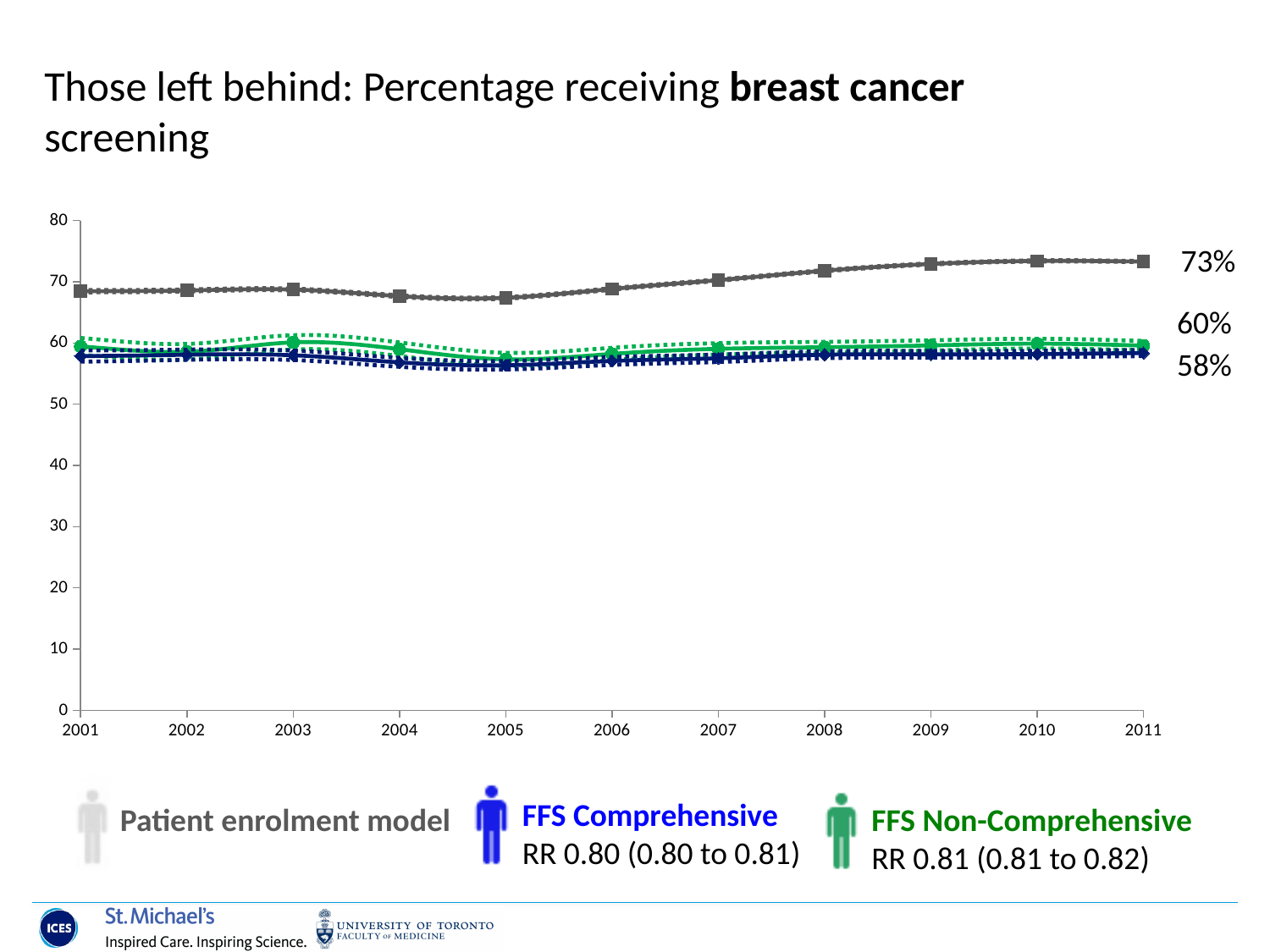
What kind of chart is shown on the slide? line chart How many series (groups) are plotted in the chart? 3 What is the difference between the 2011 percentages for the Patient enrolment model and FFS Comprehensive? 15 percentage points What percentage is labelled for the FFS Non-Comprehensive line at the end of the chart (2011)? 60% How many years are shown along the x axis of the chart? 11 Is the value for the Patient enrolment model in 2001 greater or less than 70? less Which group has the lowest percentage receiving breast cancer screening in 2011? FFS Comprehensive What percentage is labelled for the FFS Comprehensive line at the end of the chart (2011)? 58% Which group has the highest percentage receiving breast cancer screening in 2011? Patient enrolment model Does the Patient enrolment model line rise or fall overall from 2001 to 2011? rise What percentage is labelled for the Patient enrolment model line at the end of the chart (2011)? 73% What relative risk (RR) is shown for FFS Comprehensive in the legend? RR 0.80 (0.80 to 0.81)